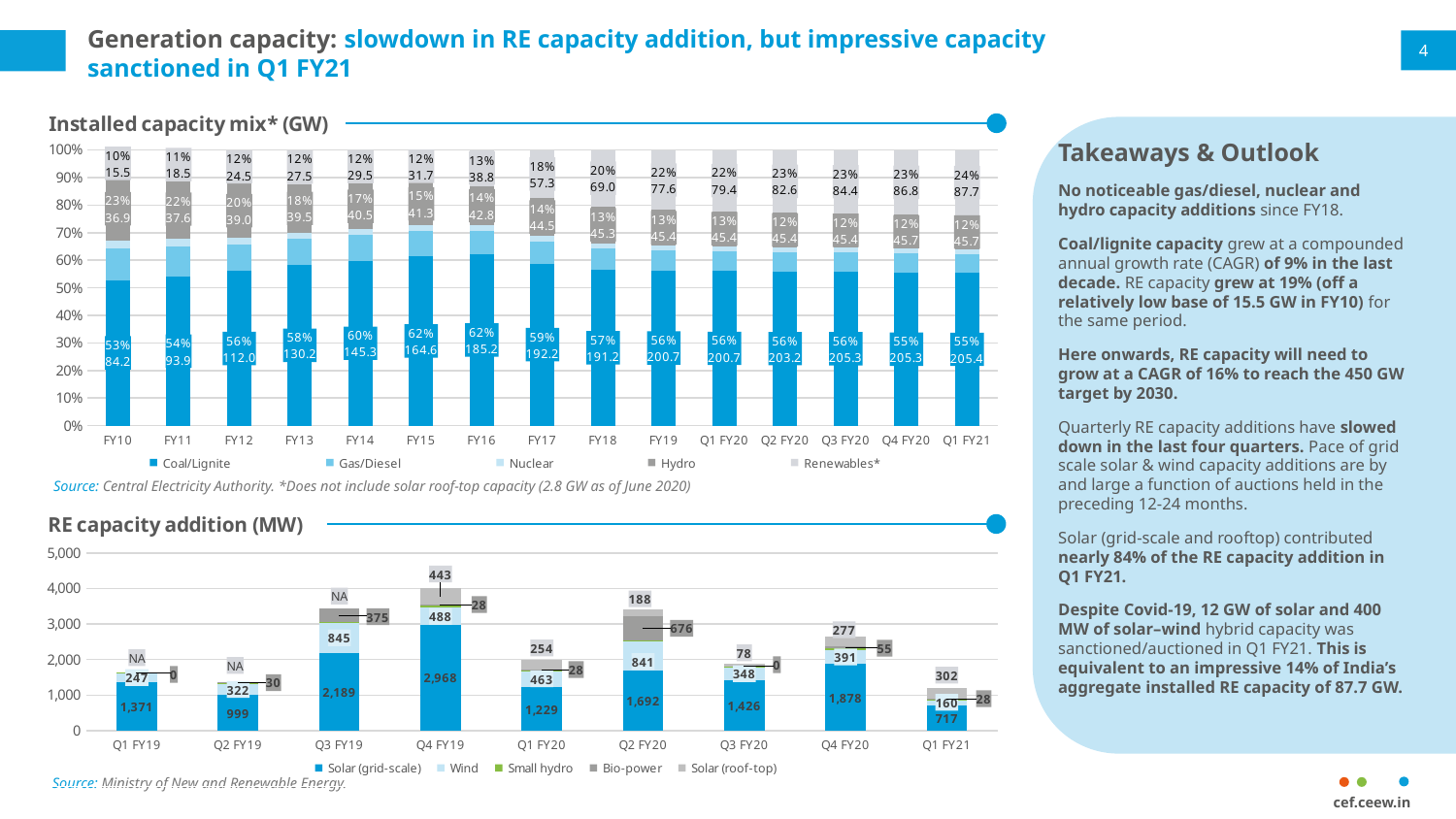
In the 'Installed capacity mix* (GW)' chart, does the Renewables* capacity in GW rise or fall from FY10 to Q1 FY21? rise In the 'Installed capacity mix* (GW)' chart, how many series does the legend list? 5 In the 'RE capacity addition (MW)' chart, is the Wind addition larger in Q3 FY19 or Q2 FY20? Q3 FY19 In the 'Installed capacity mix* (GW)' chart, what is the Coal/Lignite capacity in GW for FY10? 84.2 In the 'RE capacity addition (MW)' chart, what is the Solar (grid-scale) addition in Q4 FY19? 2,968 In the 'Installed capacity mix* (GW)' chart, how many categories are shown on the x axis? 15 In the 'Installed capacity mix* (GW)' chart, what is the difference in Coal/Lignite capacity (GW) between FY16 and FY15? 20.6 In the 'Installed capacity mix* (GW)' chart, what percentage share does Renewables* have in Q1 FY21? 24% In the 'RE capacity addition (MW)' chart, which quarter has the lowest Solar (grid-scale) addition? Q1 FY21 In the 'RE capacity addition (MW)' chart, which quarter has the highest Solar (grid-scale) addition? Q4 FY19 In the 'Installed capacity mix* (GW)' chart, what is the Renewables* capacity in GW for FY17? 57.3 What type of chart is the 'RE capacity addition (MW)' chart? stacked bar chart